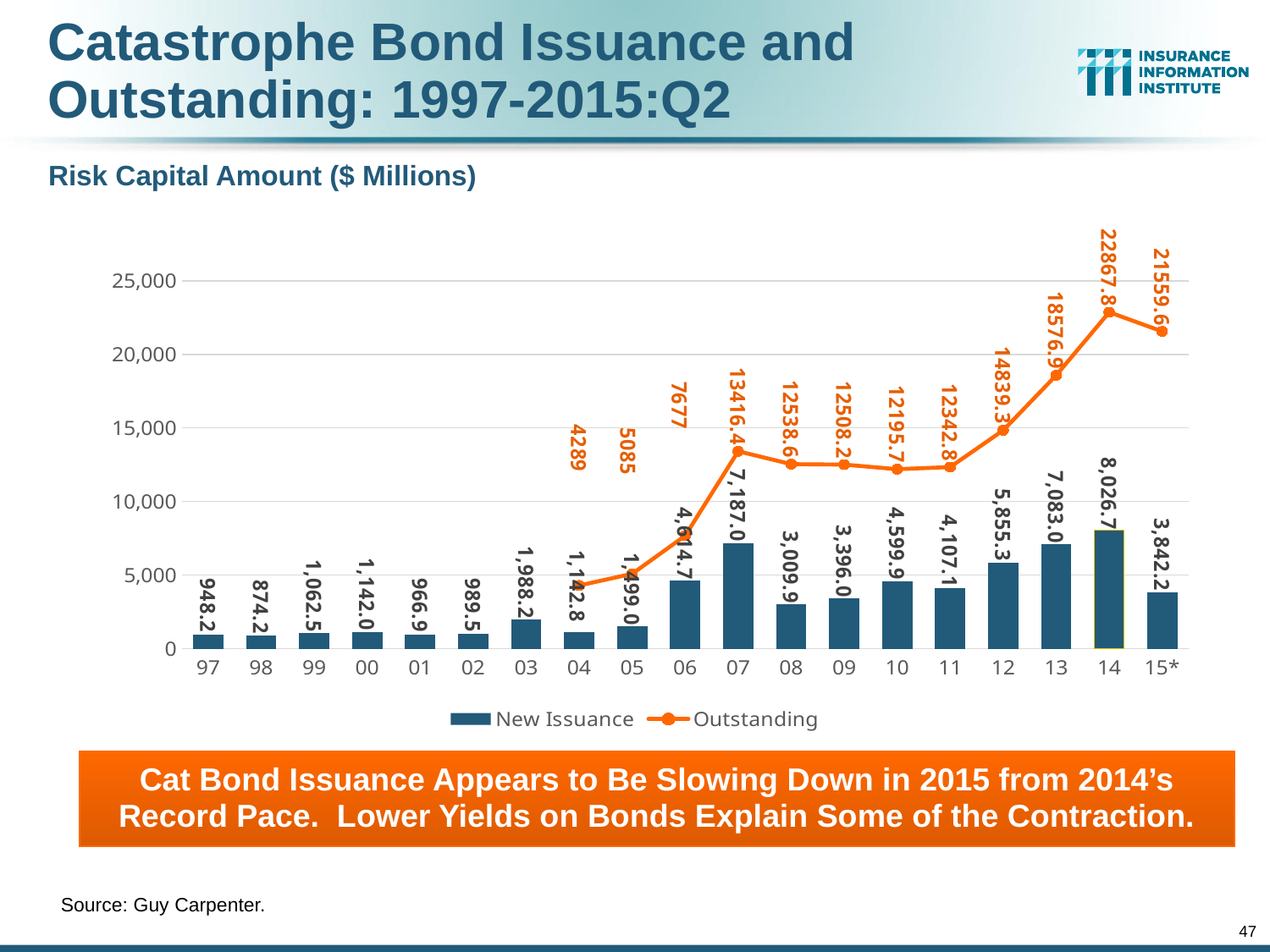
What is the Outstanding value for 04? 4289 Which year has the lowest New Issuance value? 98 Is the Outstanding value for 07 greater or less than 10,000? greater How many series does the legend list? 2 What is the New Issuance value for 14? 8,026.7 What is the Outstanding value for 14? 22867.8 What is the difference between the New Issuance values for 14 and 15*? 4,184.5 How many years are shown on the x axis? 19 Which year has the highest New Issuance value? 14 Which year has the larger Outstanding value, 12 or 13? 13 What is the New Issuance value for 07? 7,187.0 Does the Outstanding line rise or fall from 12 to 14? rise